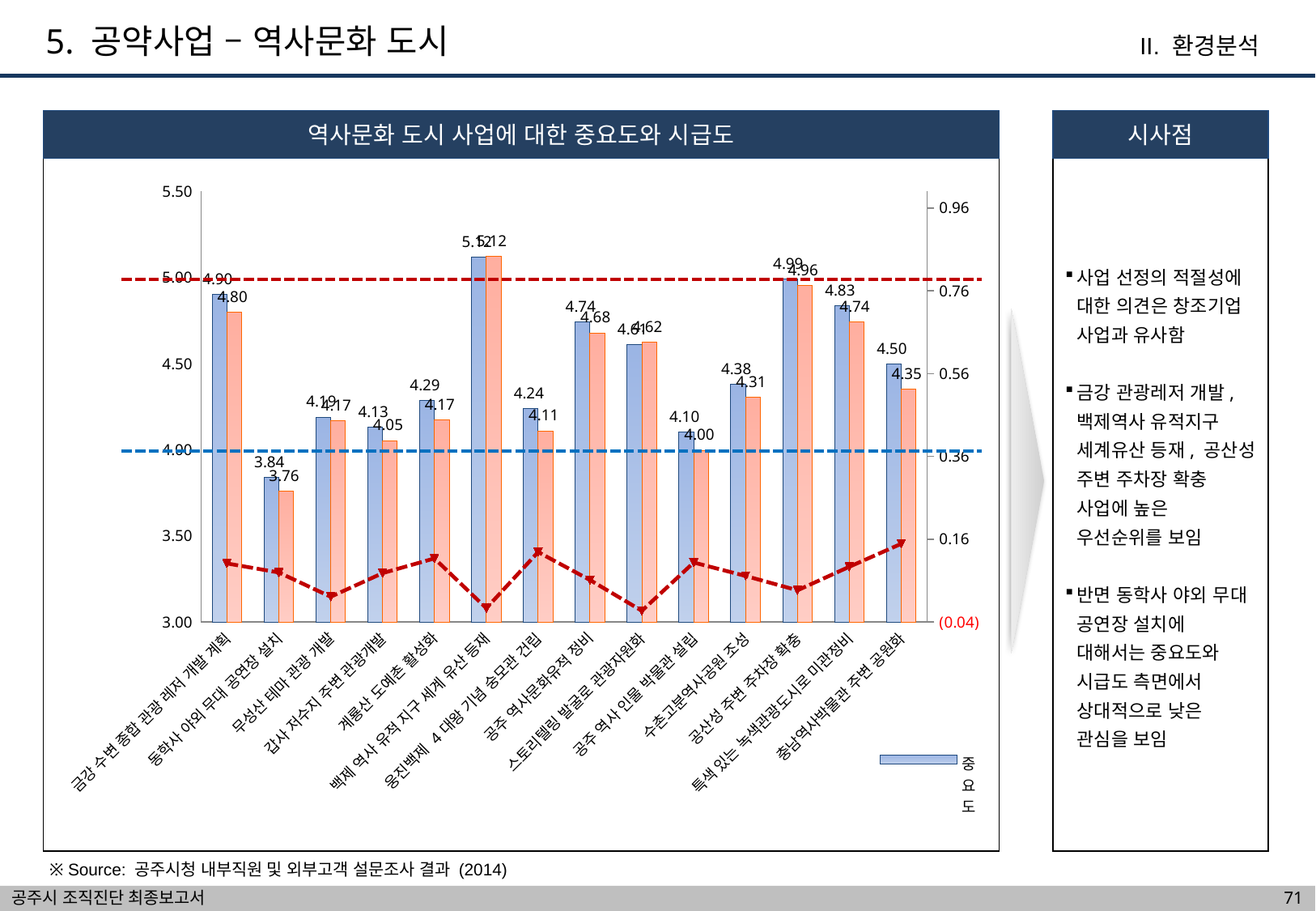
What is the 중요도 value for 공산성 주변 주차장 확충? 4.99 Which category has the highest 중요도 value? 백제 역사 유적 지구 세계 유산 등재 Is the 중요도 value for 동학사 야외 무대 공연장 설치 greater or less than 4.00? less What is the 중요도 value for 금강 수변 종합 관광 레저 개발 계획? 4.90 What is the title of the chart? 역사문화 도시 사업에 대한 중요도와 시급도 Which has a higher 중요도 value, 공주 역사문화유적 정비 or 수촌고분역사공원 조성? 공주 역사문화유적 정비 Which category has the lowest 중요도 value? 동학사 야외 무대 공연장 설치 What kind of chart is used to show the 중요도 values? bar chart What is the 중요도 value for 특색 있는 녹색관광도시로 미관정비? 4.83 How many categories are shown on the x axis of the chart? 14 What is the difference between the 중요도 values for 공산성 주변 주차장 확충 and 동학사 야외 무대 공연장 설치? 1.15 What is the 중요도 value for 충남역사박물관 주변 공원화? 4.50